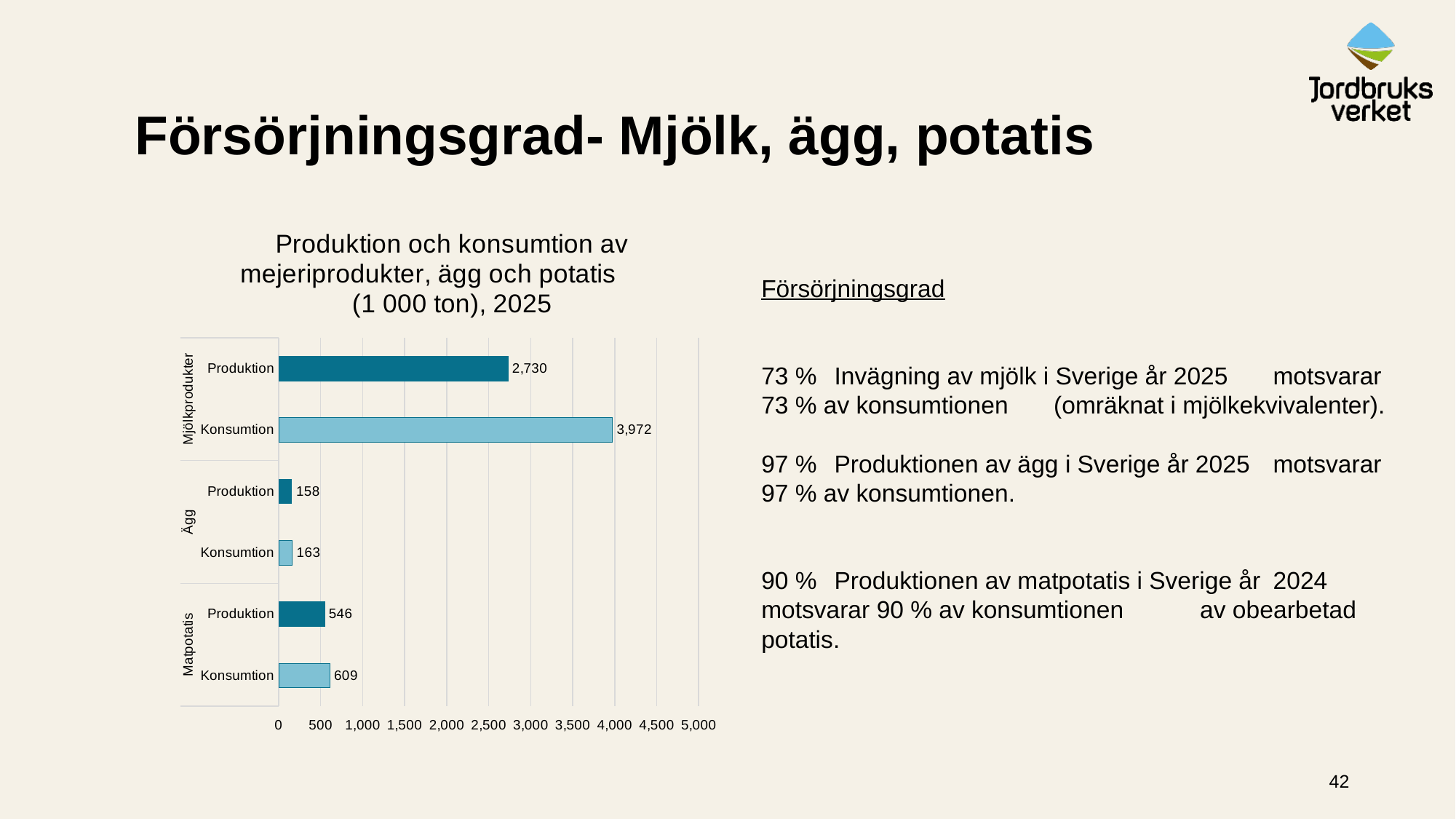
What is the value for Produktion of Ägg? 158 Which bar has the highest value in the chart? Konsumtion of Mjölkprodukter What is the value for Konsumtion of Mjölkprodukter? 3,972 What is the value for Produktion of Mjölkprodukter? 2,730 What is the difference between Konsumtion and Produktion of Mjölkprodukter? 1,242 What kind of chart is shown on the slide? Bar chart What unit is stated in the chart title? 1 000 ton Which bar has the lowest value in the chart? Produktion of Ägg How many bars are plotted in the chart? 6 What is the value for Konsumtion of Matpotatis? 609 What is the difference between Konsumtion and Produktion of Matpotatis? 63 Which is larger, Produktion of Matpotatis or Konsumtion of Ägg? Produktion of Matpotatis